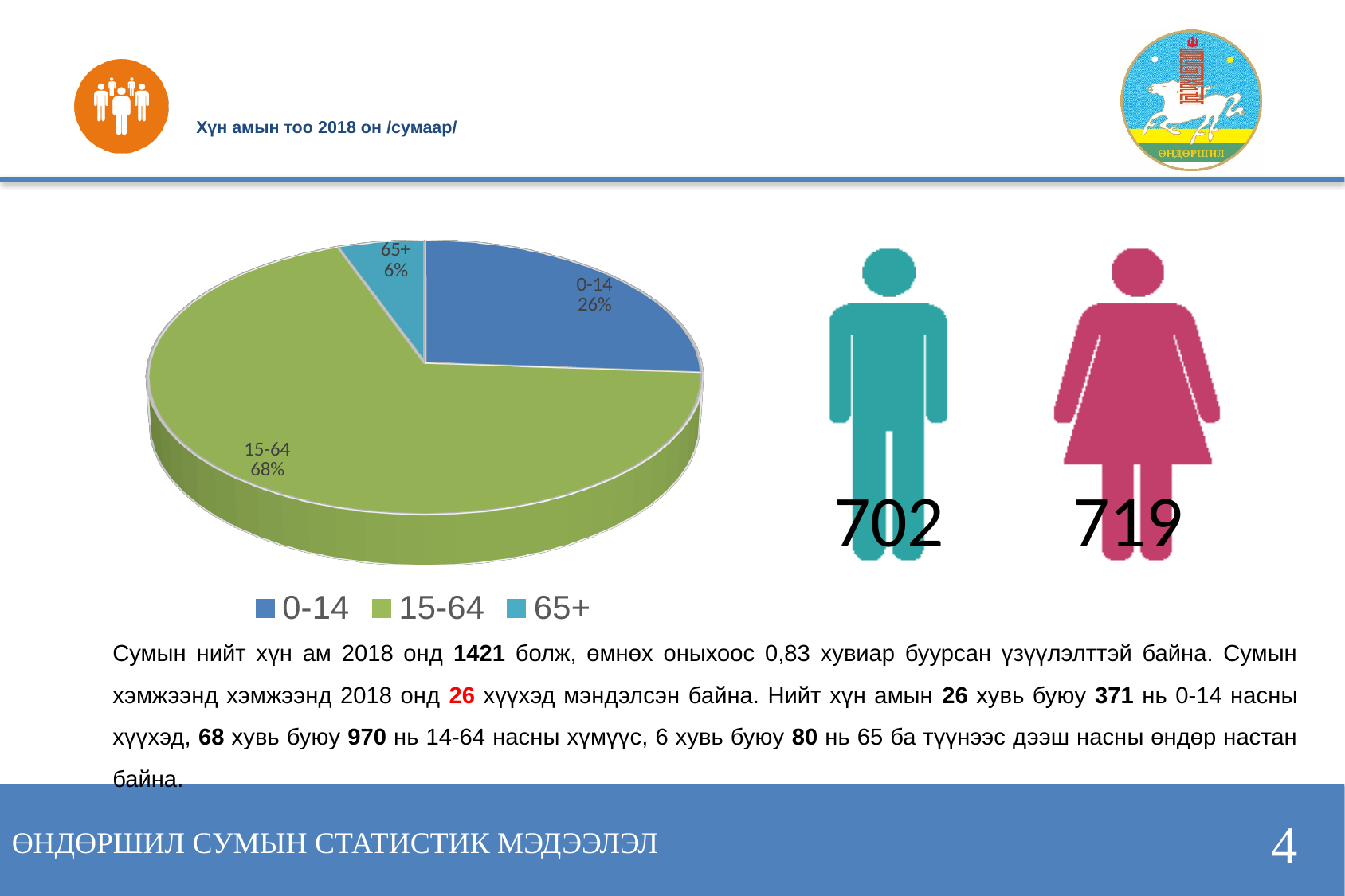
How many slices does the pie chart have? 3 Which slice is larger in the pie chart, 0-14 or 65+? 0-14 What colour is the 15-64 slice in the pie chart? Green How many entries does the legend of the pie chart list? 3 What share of the pie chart does the 15-64 age group represent? 68% What percentage is shown for the 0-14 slice of the pie chart? 26% What percentage is shown for the 65+ slice of the pie chart? 6% Which age group has the smallest slice in the pie chart? 65+ By how many percentage points does the 15-64 slice exceed the 0-14 slice? 42 percentage points What are the three legend entries of the pie chart? 0-14, 15-64, 65+ What type of chart is shown on the left of the slide? Pie chart Which age group has the largest slice in the pie chart? 15-64